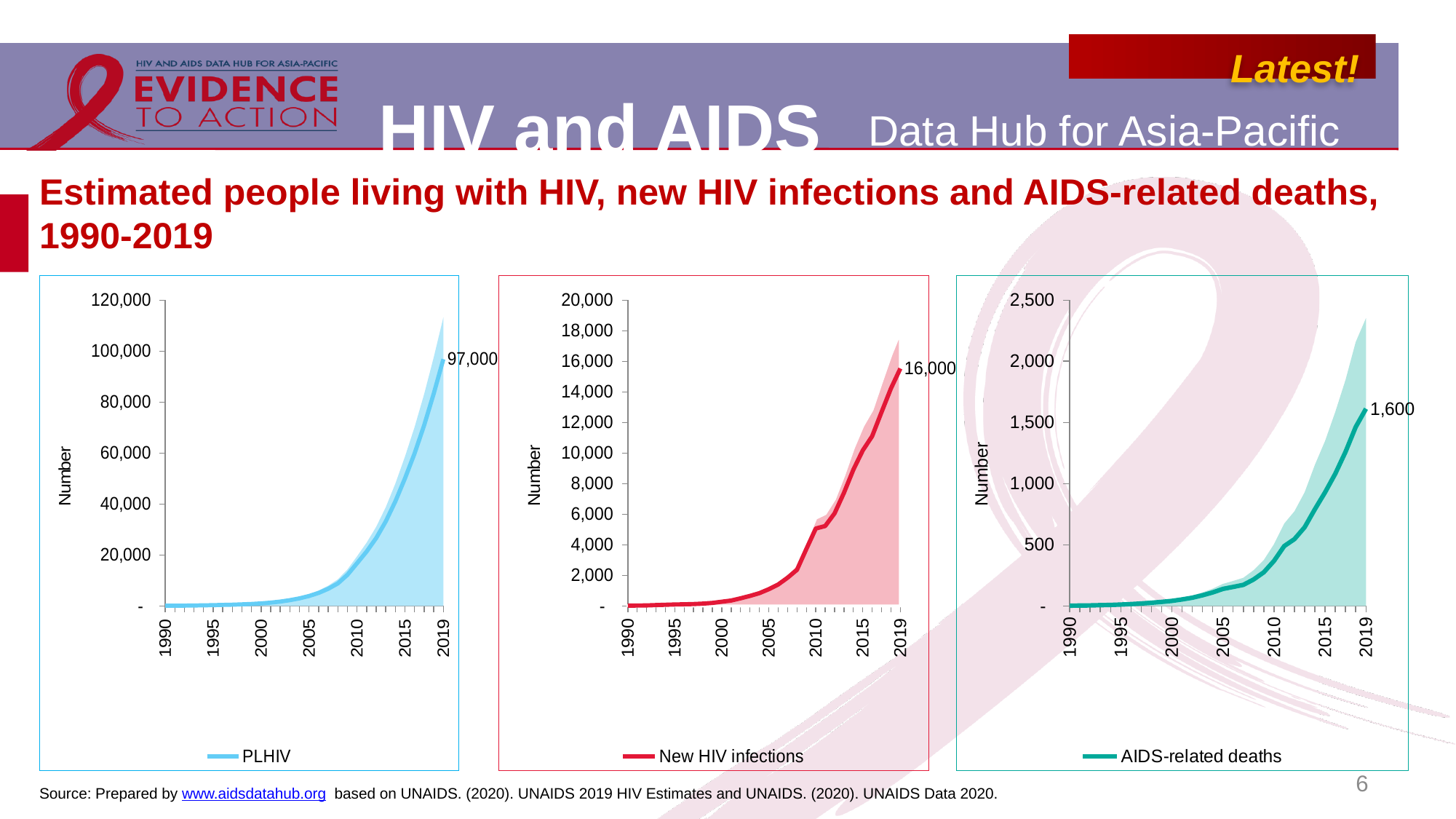
Which is larger in 2019: the PLHIV value in the left chart or the New HIV infections value in the middle chart? PLHIV In the right chart (AIDS-related deaths), what is the labelled value for 2019? 1,600 In the middle chart (New HIV infections), is the value for 2010 greater or less than 10,000? less In the right chart (AIDS-related deaths), is the value for 2010 greater or less than 1,000? less In the left chart (PLHIV), what is the labelled value for 2019? 97,000 In the left chart (PLHIV), is the value for 2010 greater or less than 40,000? less What kind of chart is the left chart (PLHIV)? Line chart with a shaded area (combination area and line chart) How many series does the legend of the middle chart list? 1 In the middle chart (New HIV infections), what is the labelled value for 2019? 16,000 In the middle chart (New HIV infections), do the values rise or fall from 1990 to 2019? Rise What is the legend entry of the right chart? AIDS-related deaths In the right chart (AIDS-related deaths), do the values rise or fall from 1990 to 2019? Rise